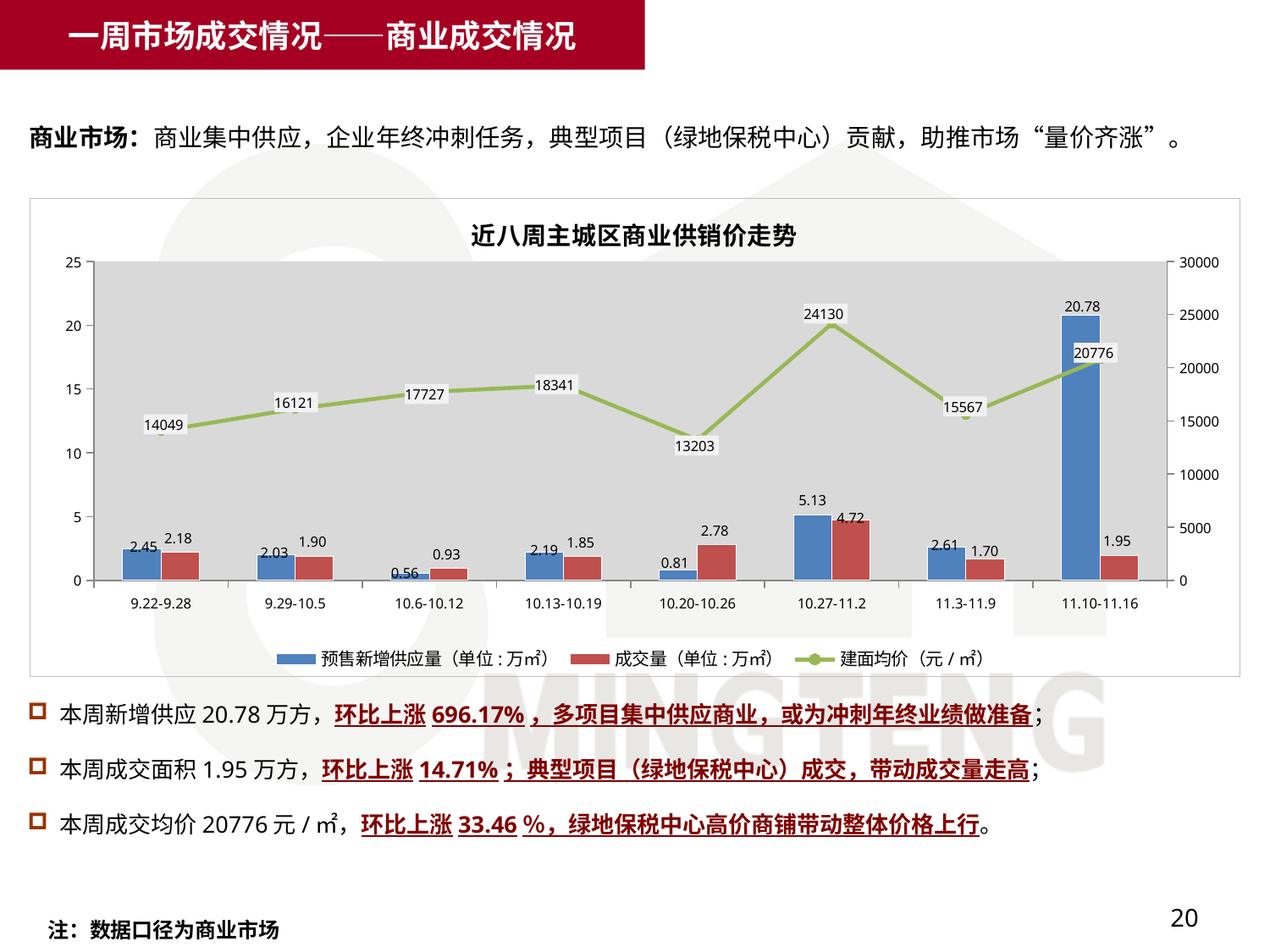
Which period has the lowest 预售新增供应量? 10.6-10.12 What is the difference in 建面均价 between 11.10-11.16 and 11.3-11.9? 5209 What is the title of the chart? 近八周主城区商业供销价走势 Which period has the highest 建面均价? 10.27-11.2 What is the 成交量 value for 10.20-10.26? 2.78 What is the difference between the 预售新增供应量 and 成交量 values for 11.10-11.16? 18.83 What is the 预售新增供应量 value for 11.10-11.16? 20.78 How many weekly periods are shown on the x axis? 8 Which is larger for 10.20-10.26, 预售新增供应量 or 成交量? 成交量 What is the 建面均价 value for 10.27-11.2? 24130 How many series does the legend list? 3 Which period has the lowest 建面均价? 10.20-10.26